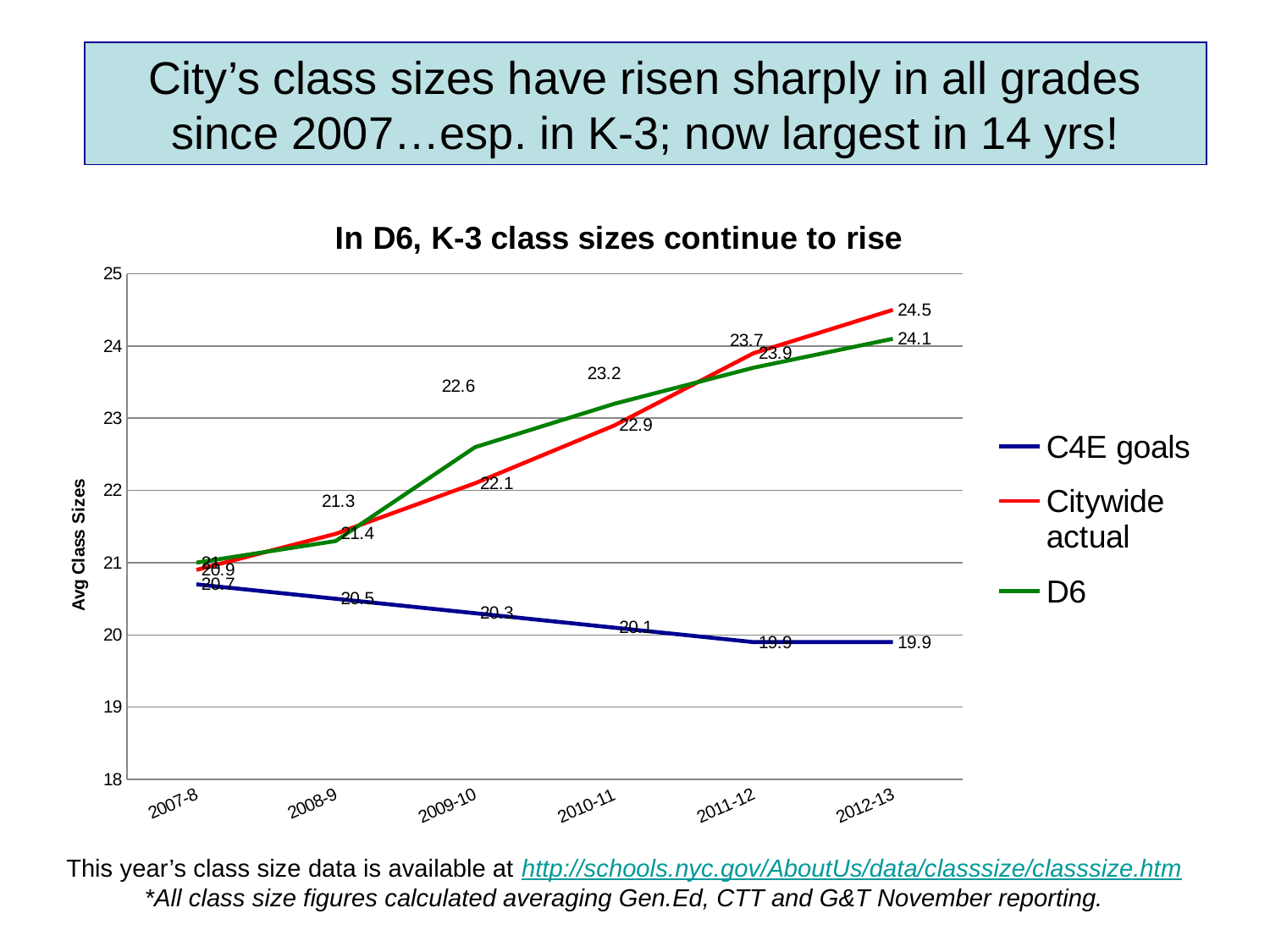
In 2009-10, which is larger: the D6 value or the Citywide actual value? D6 What is the C4E goals value for 2011-12? 19.9 What is the Citywide actual value for 2012-13? 24.5 What is the difference between the Citywide actual and D6 values in 2012-13? 0.4 How many series does the legend list? 3 What kind of chart is shown on the slide? line chart What is the title of the chart? In D6, K-3 class sizes continue to rise Do the C4E goals values rise or fall from 2007-8 to 2012-13? fall How many school years are plotted along the x axis? 6 What is the D6 value for 2010-11? 23.2 In which year is the Citywide actual value highest? 2012-13 What is the D6 value for 2012-13? 24.1